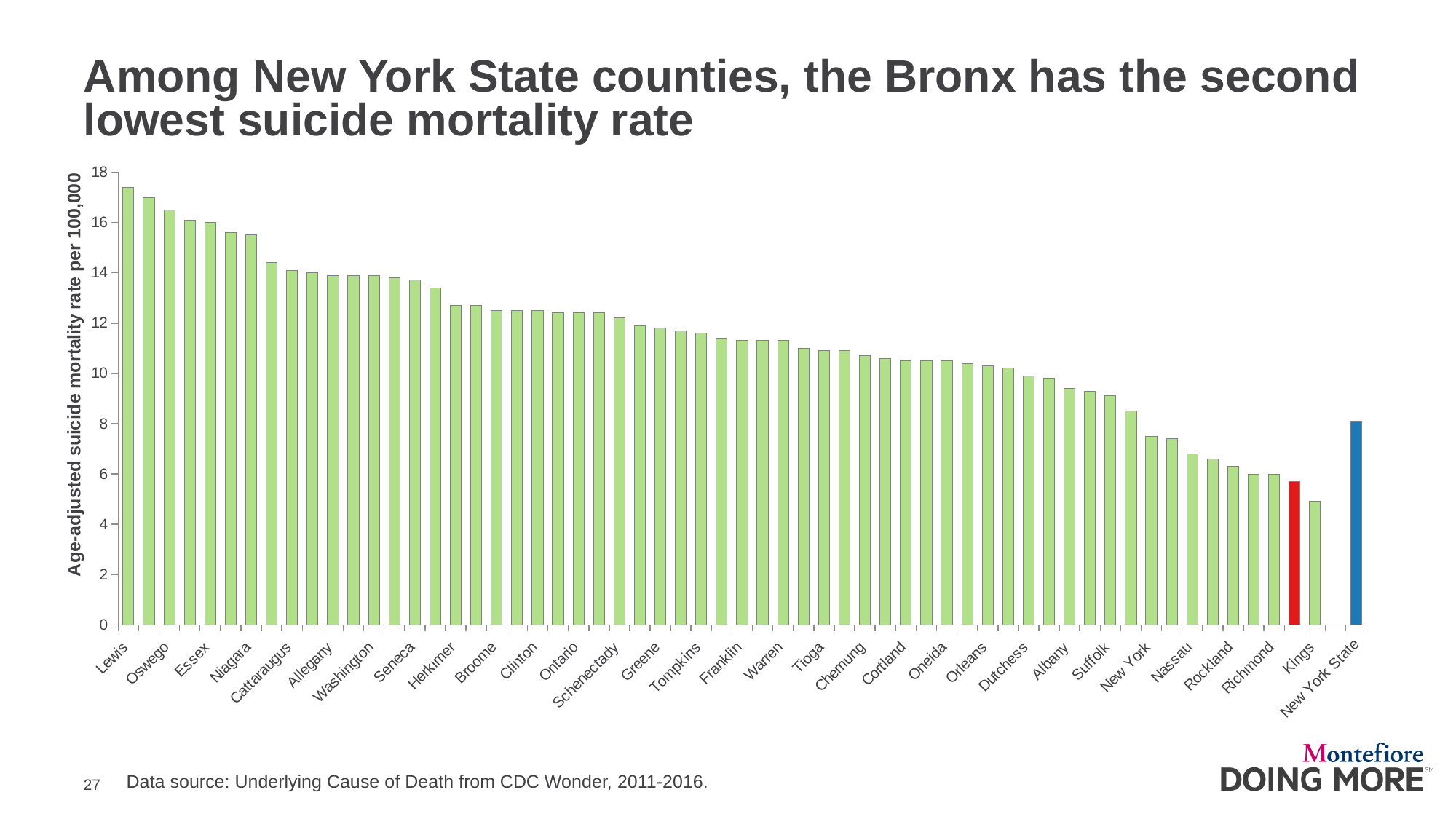
Which is larger, the value for Lewis or the value for Kings? Lewis Do the county values rise or fall moving from left to right along the x axis? fall Is the value for the Bronx (red bar) greater or less than 8? less Is the value for New York State greater or less than 10? less What kind of chart is shown on the slide? bar chart Is the value for Lewis greater or less than 16? greater Which county has the lowest age-adjusted suicide mortality rate? Kings Which county has the highest age-adjusted suicide mortality rate? Lewis What is the label on the y axis? Age-adjusted suicide mortality rate per 100,000 What colour is the bar for New York State? blue Which is larger, the value for New York State or the value for the Bronx (red bar)? New York State